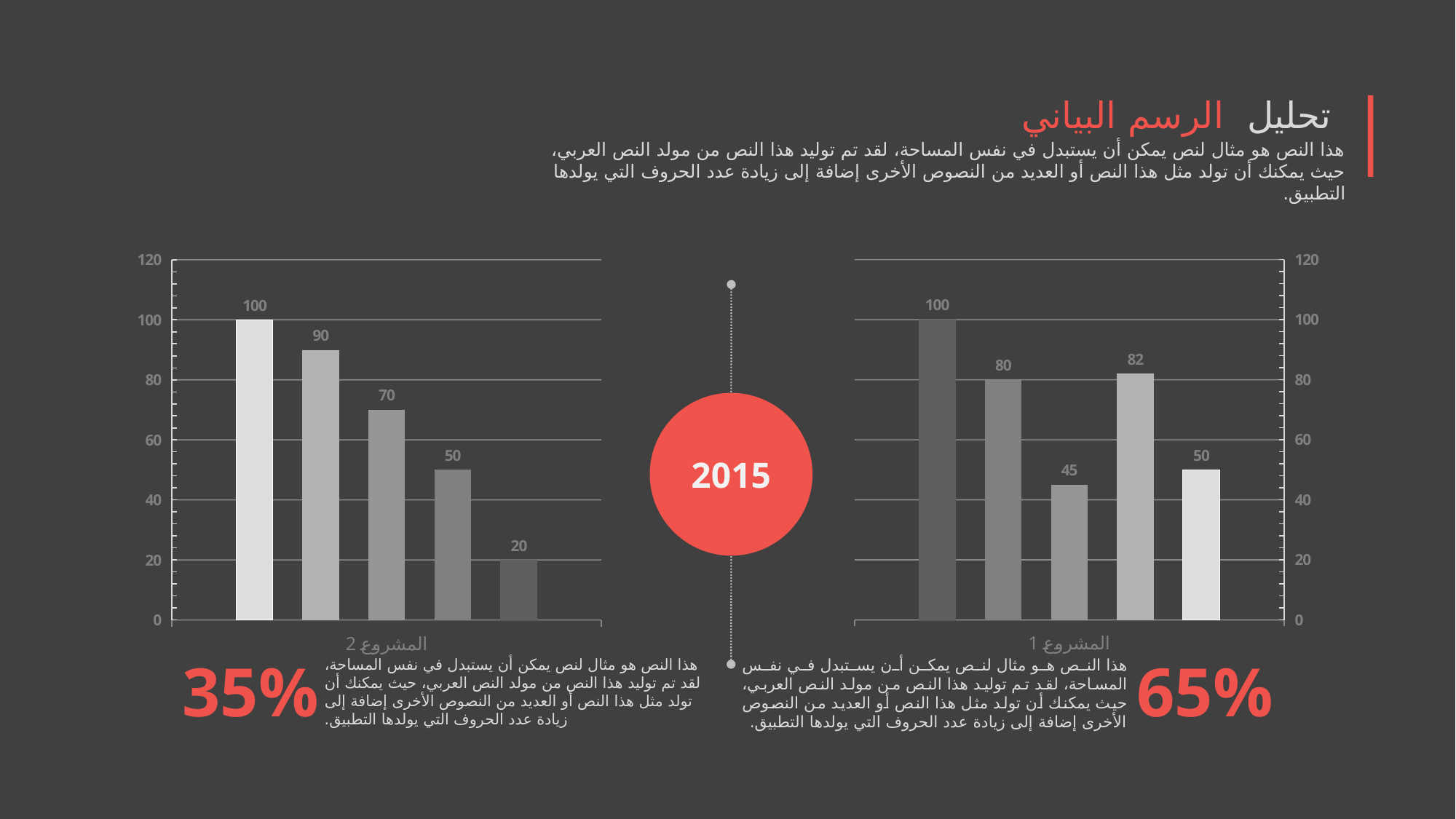
In the left chart (المشروع 2), what is the difference between the first bar (100) and the last bar (20)? 80 In the right chart (المشروع 1), what is the difference between the highest bar (100) and the lowest bar (45)? 55 In the left chart (المشروع 2), do the bar values rise or fall from left to right? fall In the right chart (المشروع 1), what is the value of the fourth bar from the left? 82 In the left chart (المشروع 2), what is the value of the tallest bar? 100 What type of chart is shown on the left side of the slide? bar chart In the right chart (المشروع 1), which is larger: the second bar (80) or the fourth bar (82)? 82 In the right chart (المشروع 1), what is the lowest bar value? 45 What year is shown in the red circle between the two charts? 2015 In the left chart (المشروع 2), how many bars are plotted? 5 In the left chart (المشروع 2), what is the value of the shortest bar? 20 In the right chart (المشروع 1), what is the value of the third bar from the left? 45